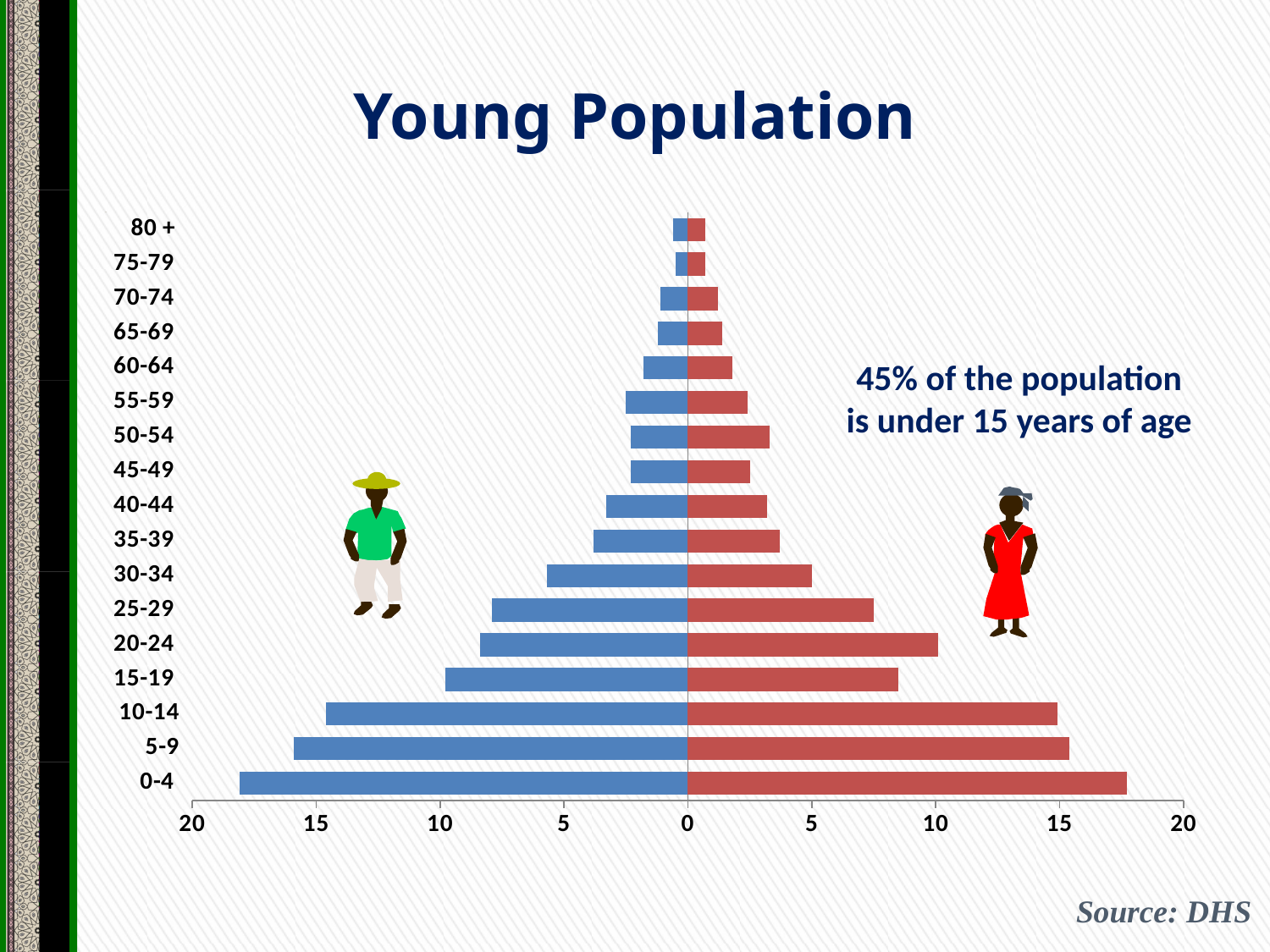
Do the bars generally get longer or shorter as the age groups increase from 0-4 to 80+? shorter Is the value of the blue bar for the 0-4 age group greater or less than 15? greater Is the value of the red bar for the 15-19 age group greater or less than 10? less What is the title of the chart? Young Population Is the value of the red bar for the 0-4 age group greater or less than 15? greater What kind of chart is shown on the slide? bar chart How many age groups are shown on the chart? 17 Which age group has the longest bars on the chart? 0-4 Which has the longer blue bar, the 0-4 age group or the 30-34 age group? 0-4